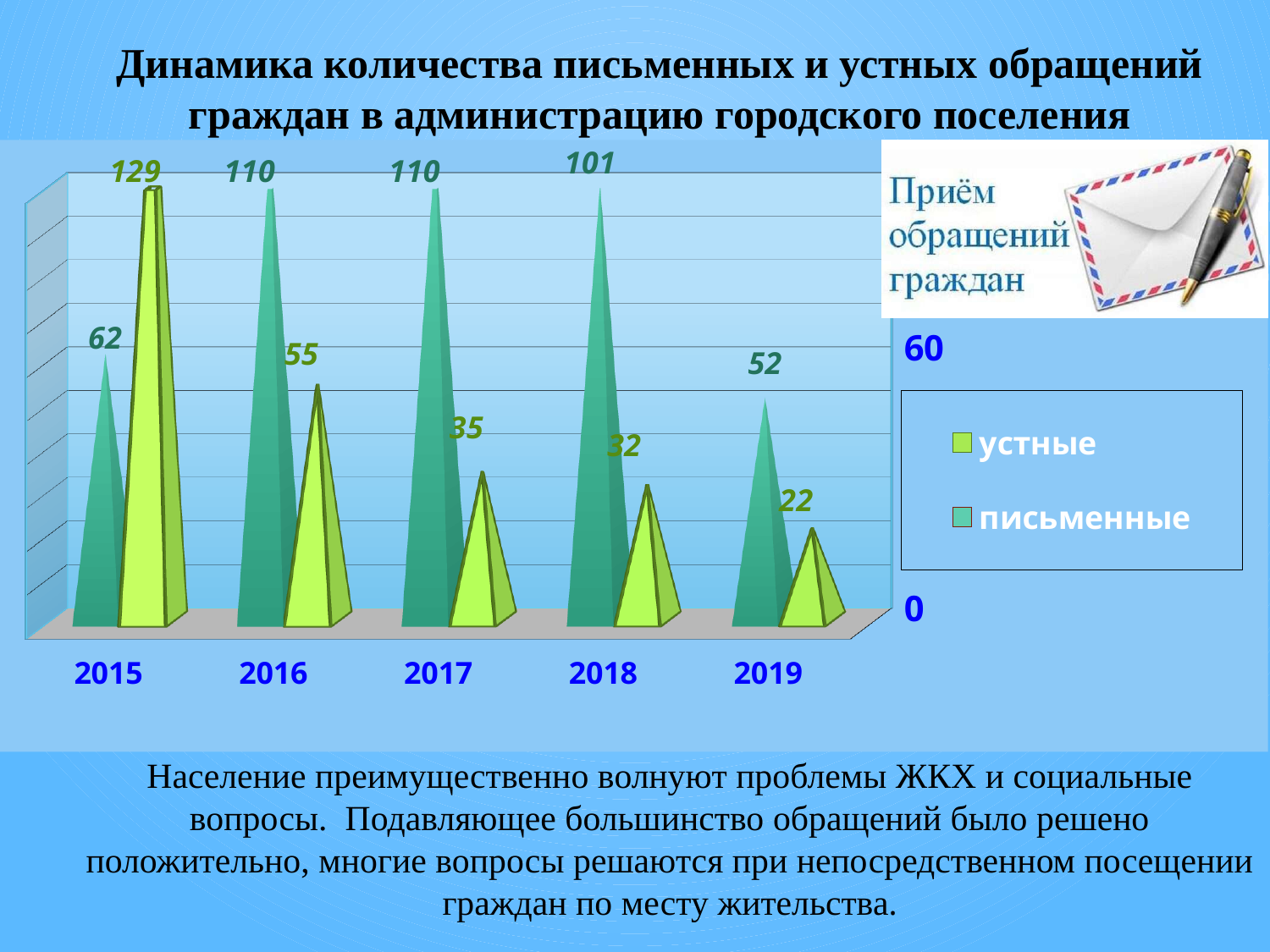
What is the value for устные in 2015? 129 In which year is the value for письменные the lowest? 2019 What is the value for устные in 2019? 22 Which is larger in 2017, письменные or устные? письменные How many years are shown on the x axis? 5 What kind of chart is shown on the slide? bar chart What is the value for письменные in 2018? 101 What is the value for письменные in 2015? 62 How many series does the legend list? 2 In which year is the value for устные the highest? 2015 What is the difference between письменные and устные in 2016? 55 Do the values for устные rise or fall from 2015 to 2019? fall